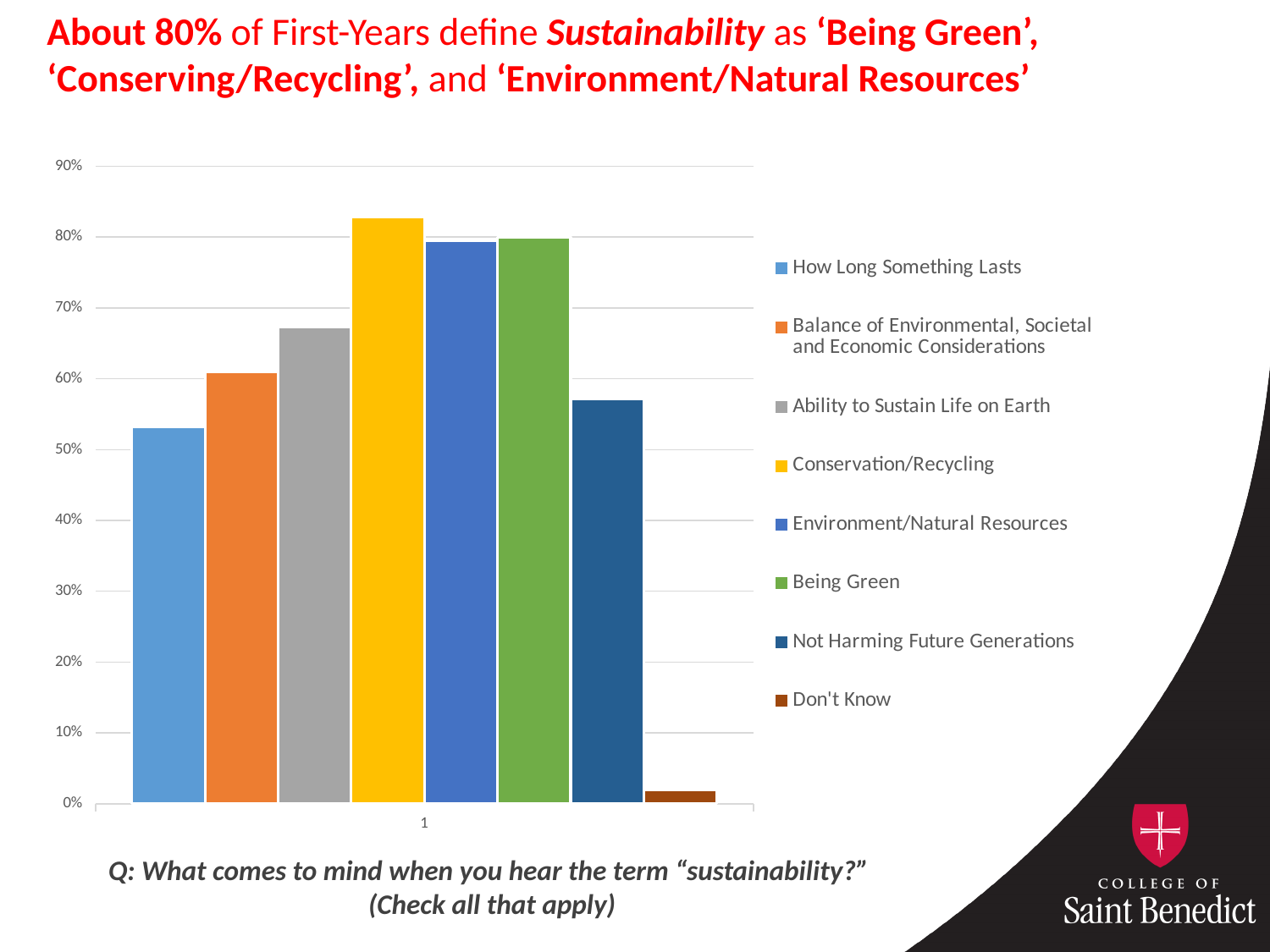
What colour is the Conservation/Recycling bar? yellow Which is larger: Not Harming Future Generations or How Long Something Lasts? Not Harming Future Generations Is the value for Conservation/Recycling greater or less than 80%? greater Is the value for Don't Know greater or less than 10%? less Which series has the highest value? Conservation/Recycling Which series has the lowest value? Don't Know Which is larger: Ability to Sustain Life on Earth or Balance of Environmental, Societal and Economic Considerations? Ability to Sustain Life on Earth Is the value for How Long Something Lasts greater or less than 50%? greater What kind of chart is shown on the slide? bar chart How many series does the legend list? 8